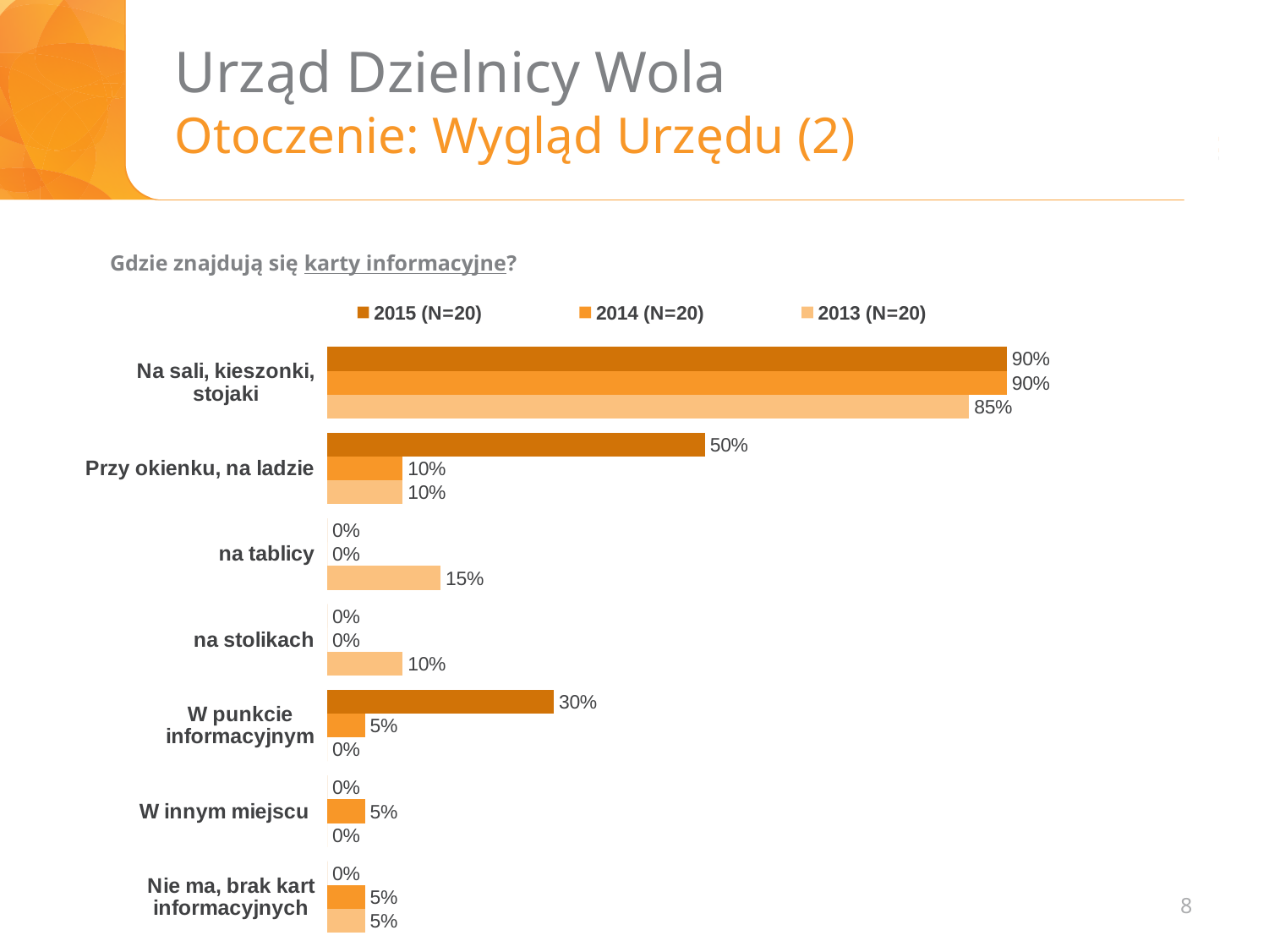
What is the value for "Na sali, kieszonki, stojaki" in the 2015 (N=20) series? 90% How many categories are shown on the chart? 7 What question does the chart answer, as stated above it? Gdzie znajdują się karty informacyjne? How many series does the legend list? 3 What is the value for "W punkcie informacyjnym" in the 2014 (N=20) series? 5% Which is larger for "W punkcie informacyjnym": the 2015 value or the 2014 value? 2015 What is the value for "Przy okienku, na ladzie" in the 2015 (N=20) series? 50% What is the value for "na tablicy" in the 2013 (N=20) series? 15% What is the difference between the 2015 and 2014 values for "Przy okienku, na ladzie"? 40% Which category has the highest value in the 2013 (N=20) series? Na sali, kieszonki, stojaki What kind of chart is shown on the slide? Bar chart What is the difference between the 2015 and 2013 values for "Na sali, kieszonki, stojaki"? 5%